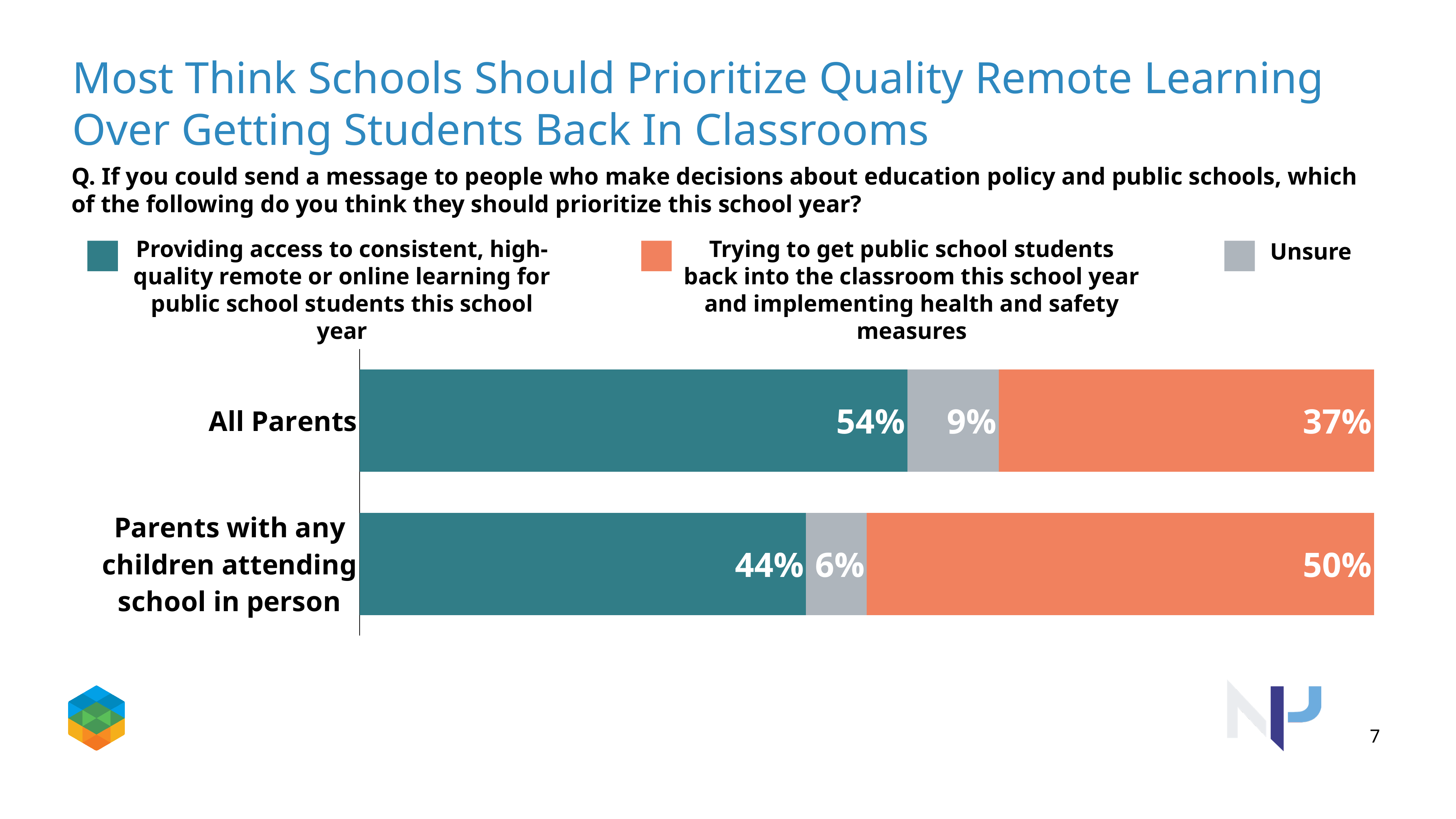
What is the total of the three segments in the All Parents bar? 100% Which colour represents the Unsure responses in the chart? Gray Which group has the higher share choosing to get students back into the classroom: All Parents or Parents with any children attending school in person? Parents with any children attending school in person What is the difference between the All Parents and the Parents with any children attending school in person values for prioritizing remote or online learning? 10 percentage points What kind of chart is shown on the slide? Stacked bar chart What percentage of All Parents were Unsure? 9% Which group has the higher Unsure share? All Parents How many series does the legend list? 3 What percentage of All Parents chose providing access to consistent, high-quality remote or online learning? 54% What percentage of Parents with any children attending school in person chose providing access to high-quality remote or online learning? 44% How many groups (bars) are shown in the chart? 2 What percentage of Parents with any children attending school in person chose trying to get public school students back into the classroom? 50%